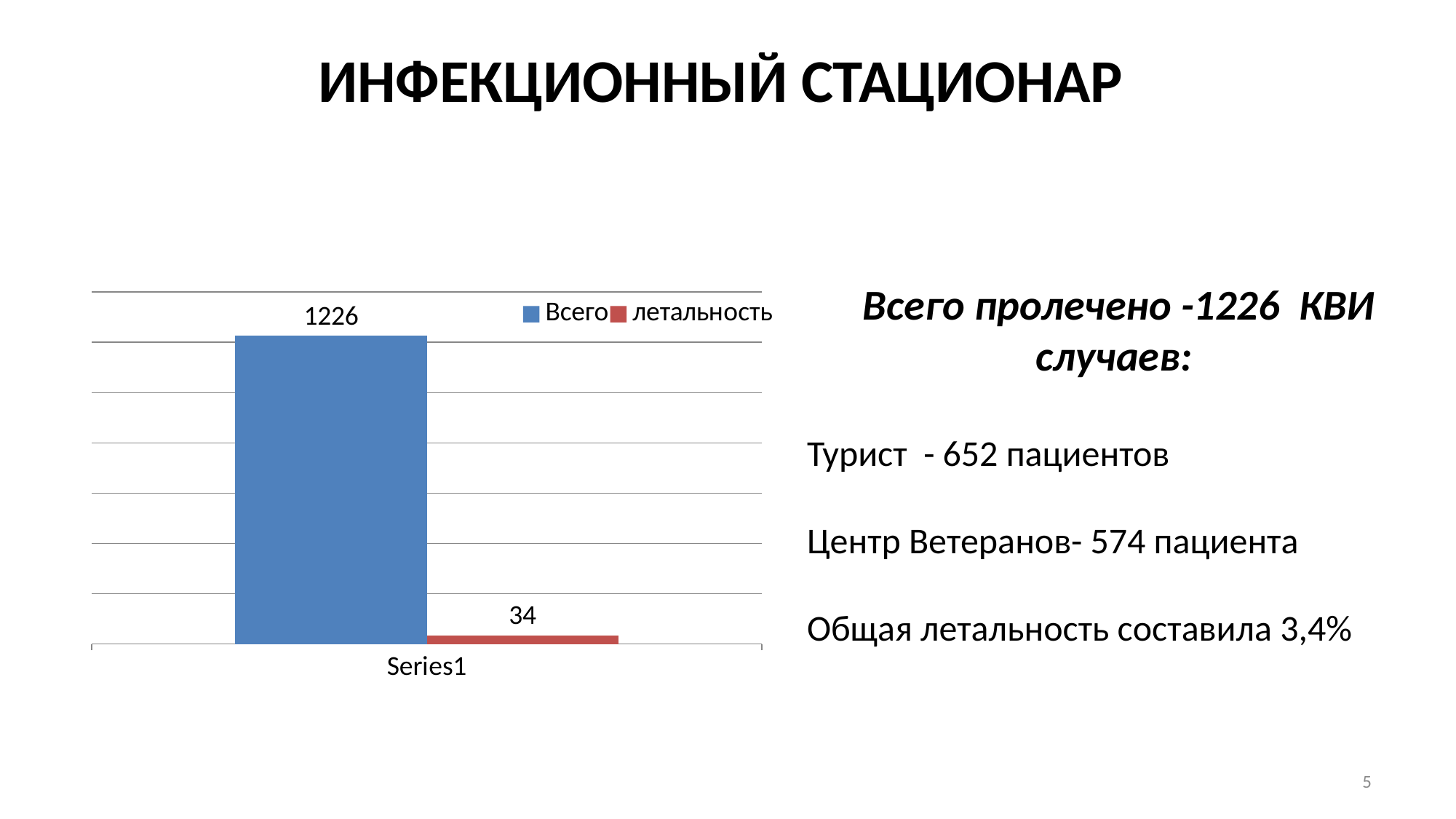
What is the value of the "летальность" bar? 34 Which series has the lowest value on the chart? летальность What colour is the "летальность" bar? Red What is the difference between the "Всего" value and the "летальность" value? 1192 What is the category label on the x axis? Series1 What is the value of the "Всего" bar? 1226 What kind of chart is shown on the slide? Bar chart How many categories are shown on the x axis? 1 Which series has the higher value, "Всего" or "летальность"? Всего How many series does the legend list? 2